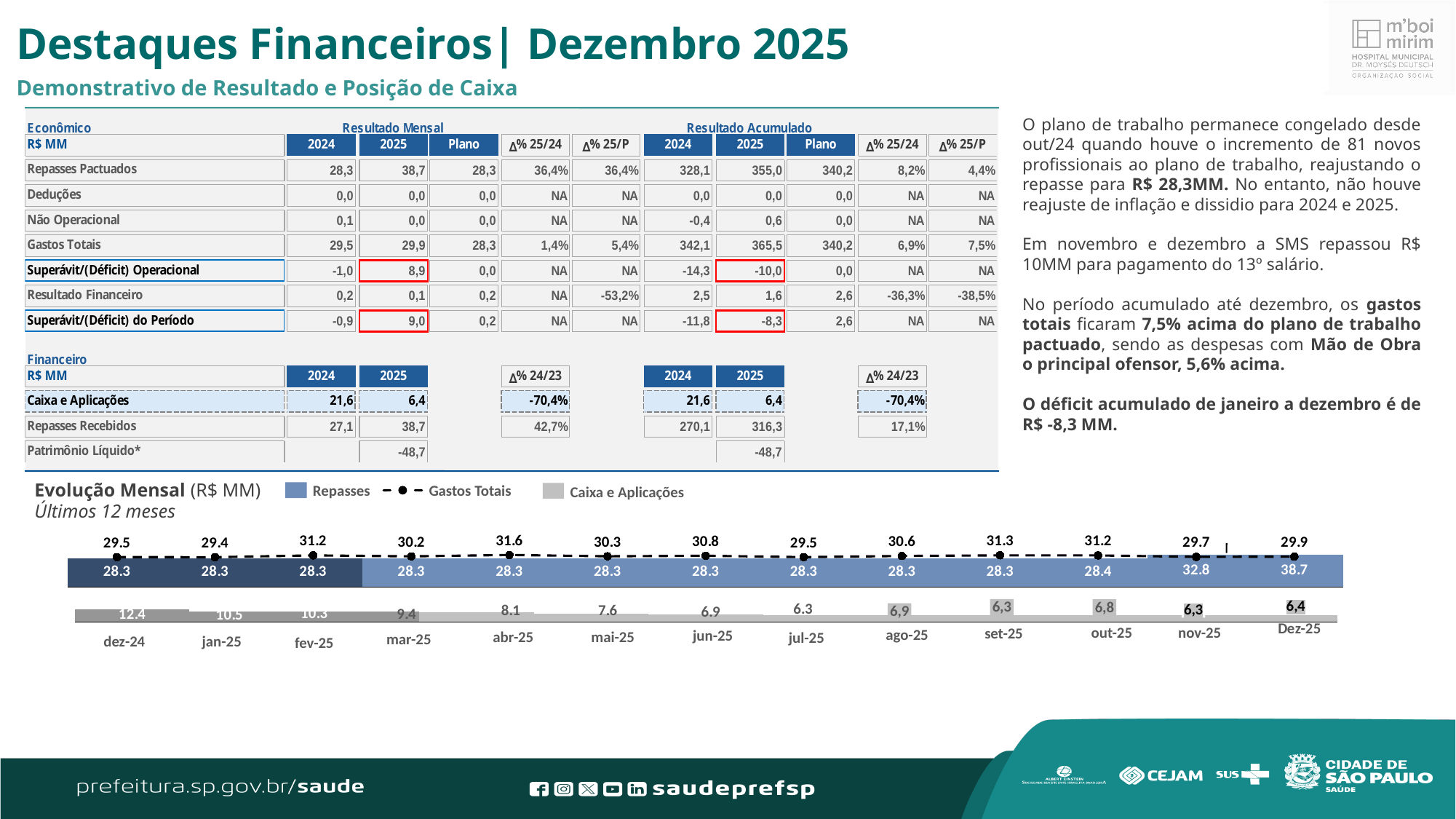
In the Evolução Mensal chart, what is the Repasses value for out-25? 28.4 In the Evolução Mensal chart, what is the Gastos Totais value for abr-25? 31.6 In the Evolução Mensal chart, which series is drawn as a dashed line with markers? Gastos Totais How many months are shown on the x axis of the Evolução Mensal chart? 13 In the Evolução Mensal chart, what is the Repasses value for Dez-25? 38.7 In the Evolução Mensal chart, does Caixa e Aplicações generally rise or fall from dez-24 to jul-25? fall In the Evolução Mensal chart, what is the Caixa e Aplicações value for dez-24? 12.4 In the Evolução Mensal chart, what is the difference between Repasses in Dez-25 and nov-25? 5.9 In the Evolução Mensal chart, which month has the lowest Caixa e Aplicações value? jul-25, set-25 and nov-25 (tied at 6.3) In the Evolução Mensal chart, which is larger in mar-25: Gastos Totais or Repasses? Gastos Totais In the Evolução Mensal chart, which month has the highest Repasses value? Dez-25 How many series does the legend of the Evolução Mensal chart list? 3